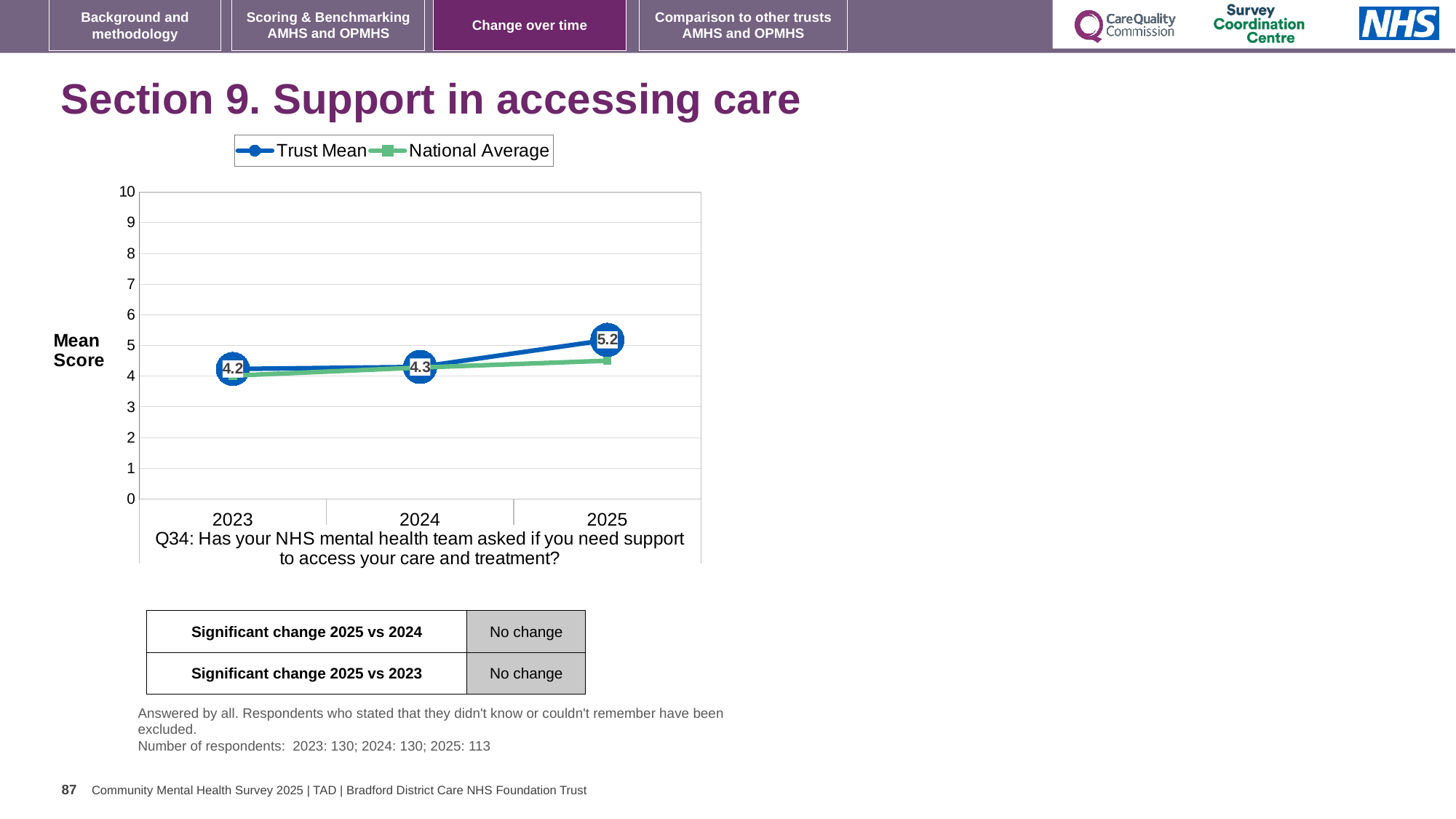
How many years are shown on the x axis of the chart? 3 In 2025, which is larger: the Trust Mean or the National Average? Trust Mean What is the difference between the Trust Mean score in 2025 and in 2024? 0.9 What is the Trust Mean score for 2023? 4.2 What is the Trust Mean score for 2024? 4.3 What is the difference between the Trust Mean score in 2025 and in 2023? 1.0 What is the Trust Mean score for 2025? 5.2 What kind of chart is shown on the slide? Line chart In which year is the Trust Mean score highest? 2025 Is the National Average value for 2025 greater or less than 5? less In which year is the Trust Mean score lowest? 2023 How many series does the chart legend list? 2